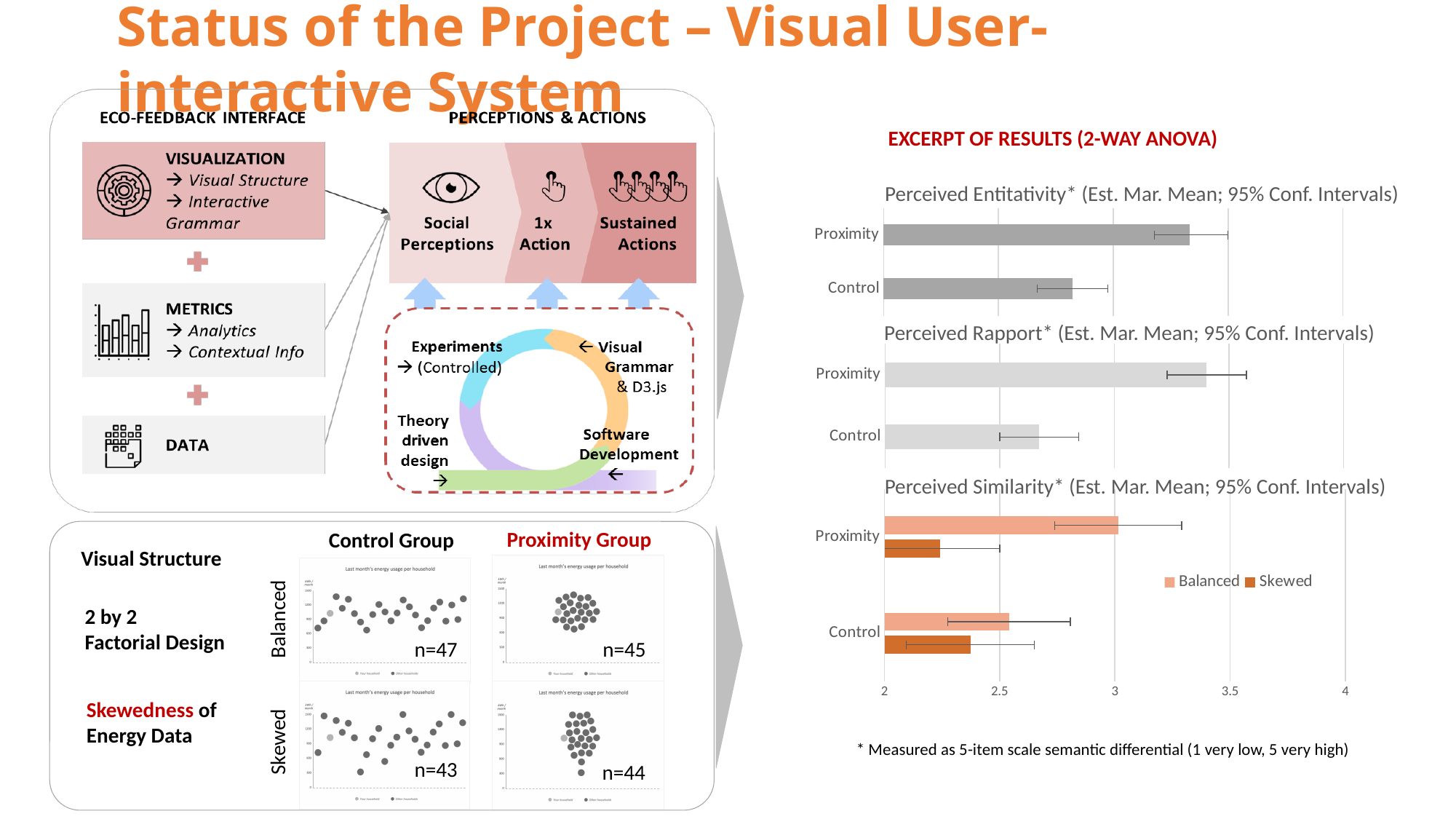
In the Perceived Rapport chart, which group has the higher value, Proximity or Control? Proximity In the Perceived Similarity chart, is the Skewed value for Proximity greater or less than 2.5? less In the Perceived Entitativity chart, which group has the higher value, Proximity or Control? Proximity How many series does the legend of the Perceived Similarity chart list? 2 In the Perceived Similarity chart, is the Balanced value for Proximity greater or less than 2.5? greater What kind of chart is the Perceived Entitativity chart? bar chart In the Perceived Entitativity chart, is the value for Proximity greater or less than 3? greater In the Perceived Similarity chart, which series is larger for the Proximity group, Balanced or Skewed? Balanced What are the two series named in the legend of the Perceived Similarity chart? Balanced and Skewed How many categories are shown in the Perceived Rapport chart? 2